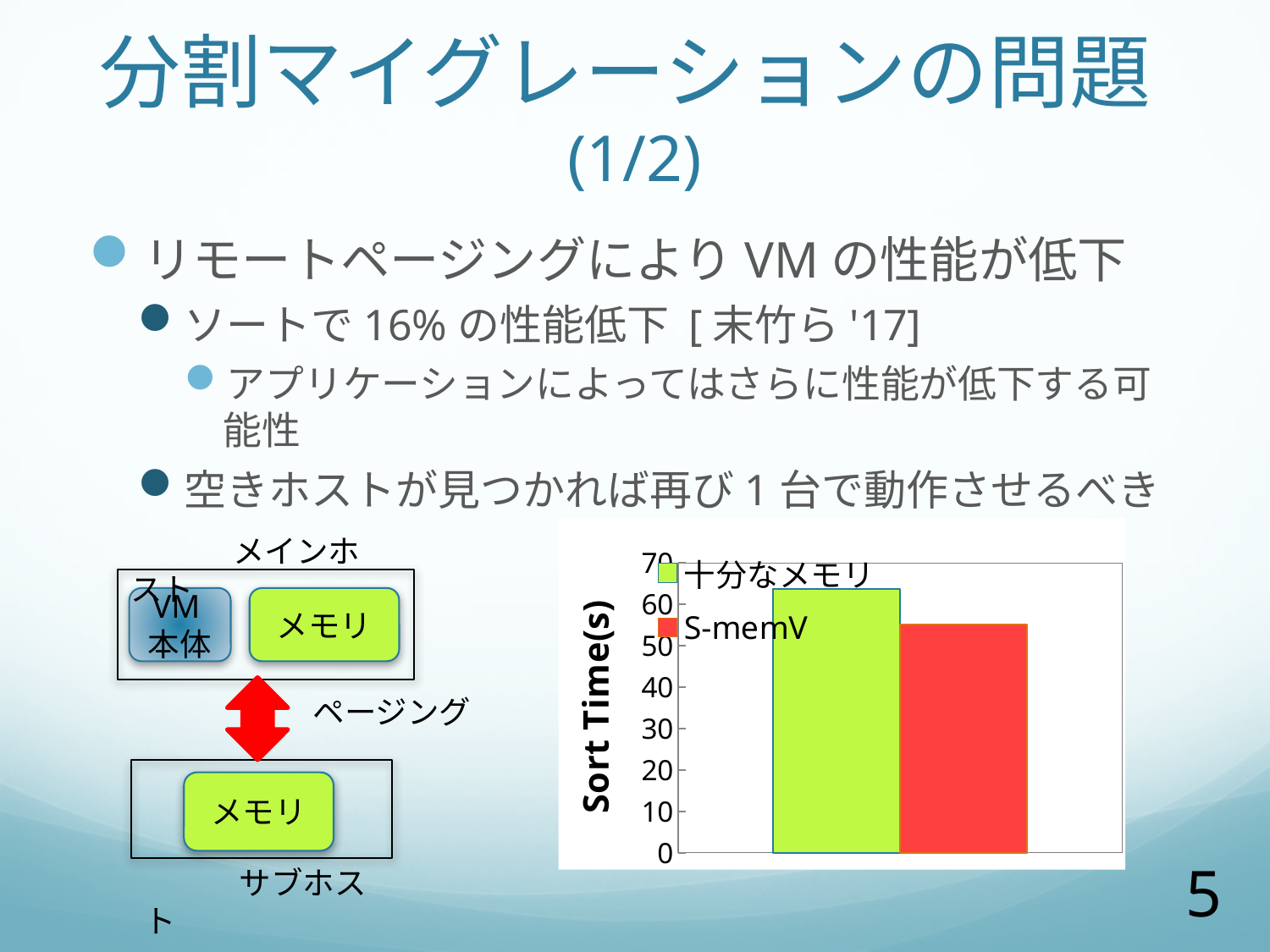
What are the two entries in the chart's legend? 十分なメモリ and S-memV What is the label of the chart's vertical axis? Sort Time(s) What kind of chart is shown on the slide? bar chart Which series has the highest sort time in the chart? 十分なメモリ How many bars are plotted in the chart? 2 Is the sort time for S-memV greater or less than 60? less Which series has the higher sort time, 十分なメモリ or S-memV? 十分なメモリ Is the sort time for 十分なメモリ greater or less than 70? less How many series does the chart's legend list? 2 Is the sort time for 十分なメモリ greater or less than 60? greater Which series has the lowest sort time in the chart? S-memV